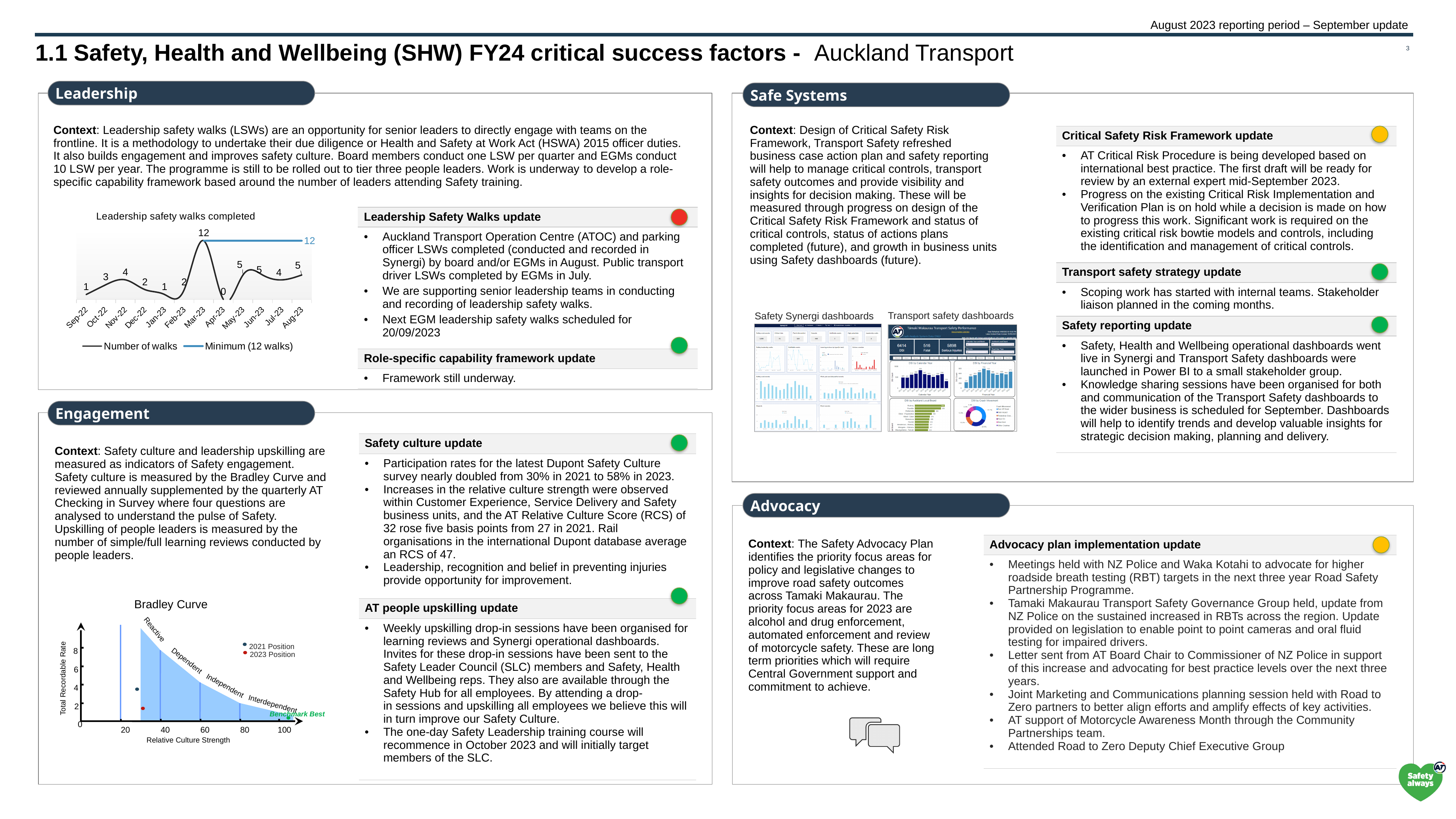
In the 'Leadership safety walks completed' chart, which month has the highest number of walks? Mar-23 In the 'Leadership safety walks completed' chart, how many walks were completed in Apr-23? 0 In the 'Leadership safety walks completed' chart, which month had more walks, Nov-22 or Dec-22? Nov-22 What kind of chart is 'Leadership safety walks completed'? Line chart In the 'Leadership safety walks completed' chart, how many months are shown on the x axis? 12 In the 'Leadership safety walks completed' chart, how many walks were completed in Aug-23? 5 In the 'Leadership safety walks completed' chart, which month has the lowest number of walks? Apr-23 In the 'Leadership safety walks completed' chart, what is the difference between the number of walks in Mar-23 and Apr-23? 12 In the Bradley Curve chart, what are the two positions shown in the legend? 2021 Position and 2023 Position In the 'Leadership safety walks completed' chart, how many walks were completed in Mar-23? 12 In the 'Leadership safety walks completed' chart, what value does the 'Minimum (12 walks)' line sit at? 12 How many series does the legend of the 'Leadership safety walks completed' chart list? 2